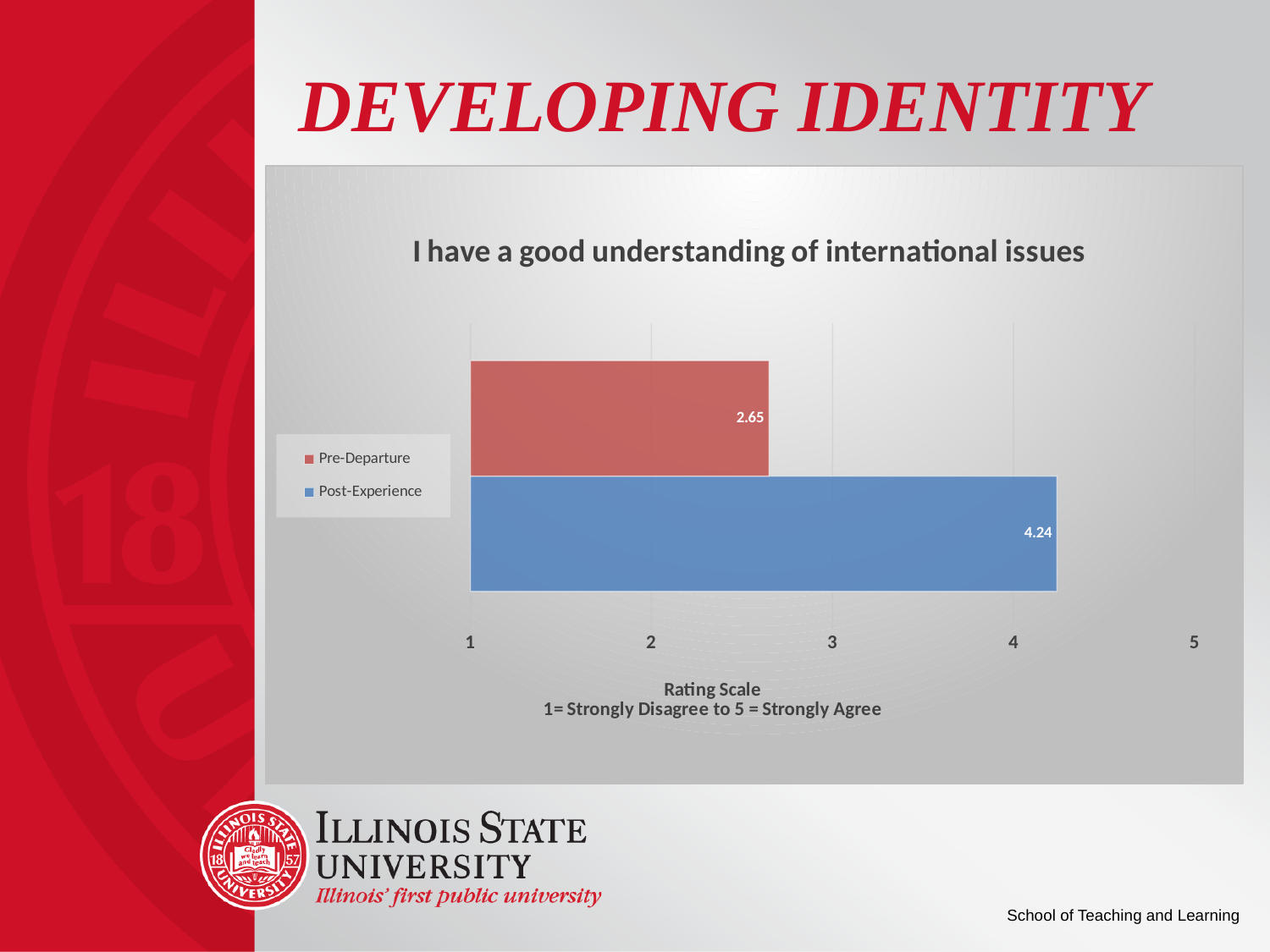
What is the value for Post-Experience? 4.24 What is the label of the horizontal axis? Rating Scale 1= Strongly Disagree to 5 = Strongly Agree What is the difference between the Post-Experience and Pre-Departure values? 1.59 What is the title of the chart? I have a good understanding of international issues Which series has the lowest value? Pre-Departure Is the value for Pre-Departure greater or less than 3? less Is the value for Post-Experience greater or less than 4? greater What kind of chart is shown on the slide? bar chart How many bars are plotted in the chart? 2 How many series does the legend list? 2 What is the value for Pre-Departure? 2.65 Which series has the higher value, Pre-Departure or Post-Experience? Post-Experience